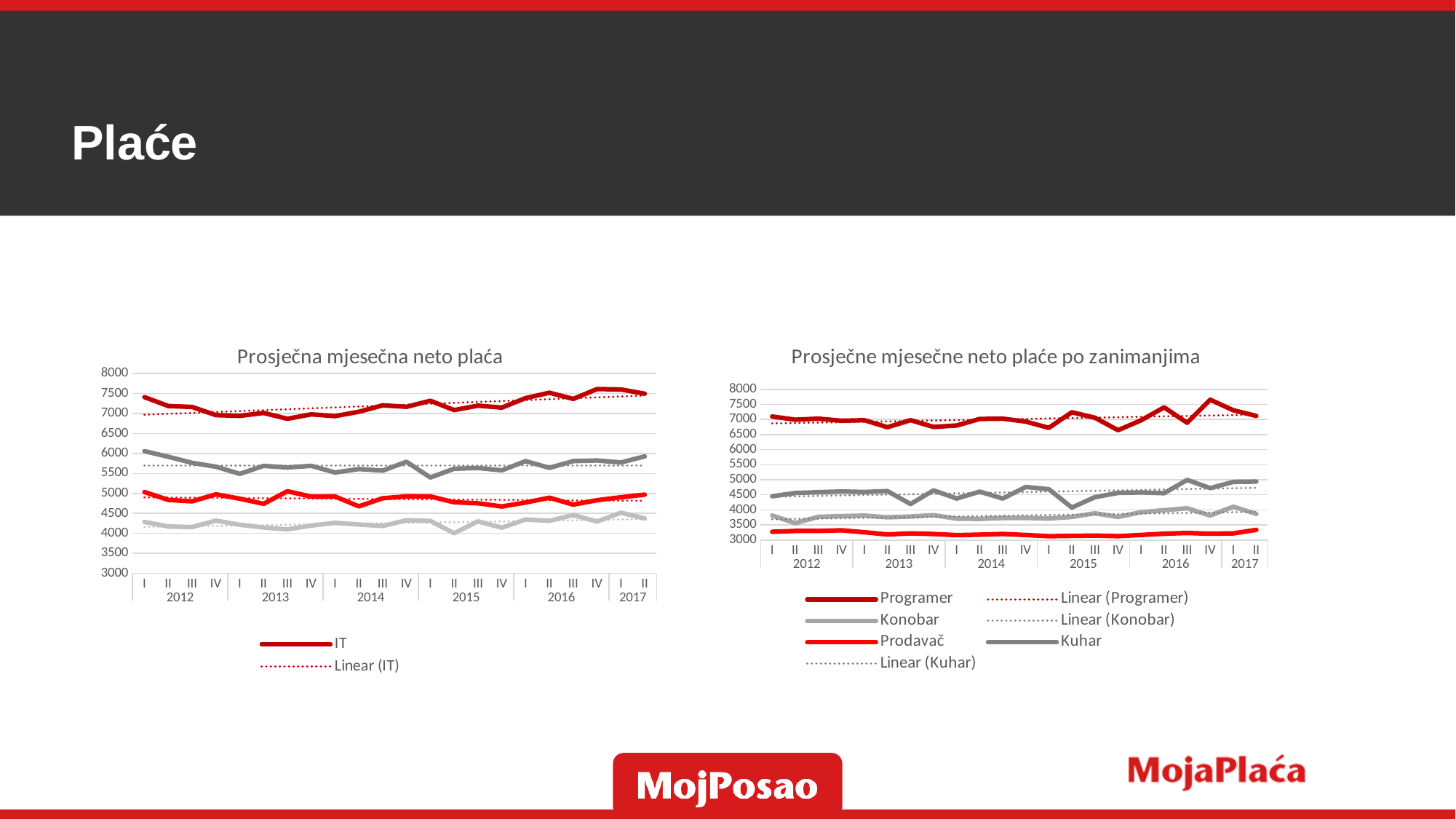
In the right chart, does the Kuhar line overall rise or fall from 2012 to 2017? rise In the right chart, which occupation has the highest values across the whole period? Programer In the right chart, which is larger in quarter I of 2017: Kuhar or Konobar? Kuhar In the left chart, is the value for IT in quarter I of 2012 greater or less than 7000? greater In the right chart "Prosječne mjesečne neto plaće po zanimanjima", how many entries does the legend list? 7 In the right chart, is the value for Programer in quarter IV of 2016 greater or less than 7500? greater How many years are labelled on the x axis of the right chart? 6 What kind of chart is the left chart titled "Prosječna mjesečna neto plaća"? line chart In the right chart, is the value for Kuhar in quarter I of 2012 greater or less than 5000? less In the left chart "Prosječna mjesečna neto plaća", how many entries does the legend list? 2 In the right chart, which occupation has the lowest values across the whole period? Prodavač